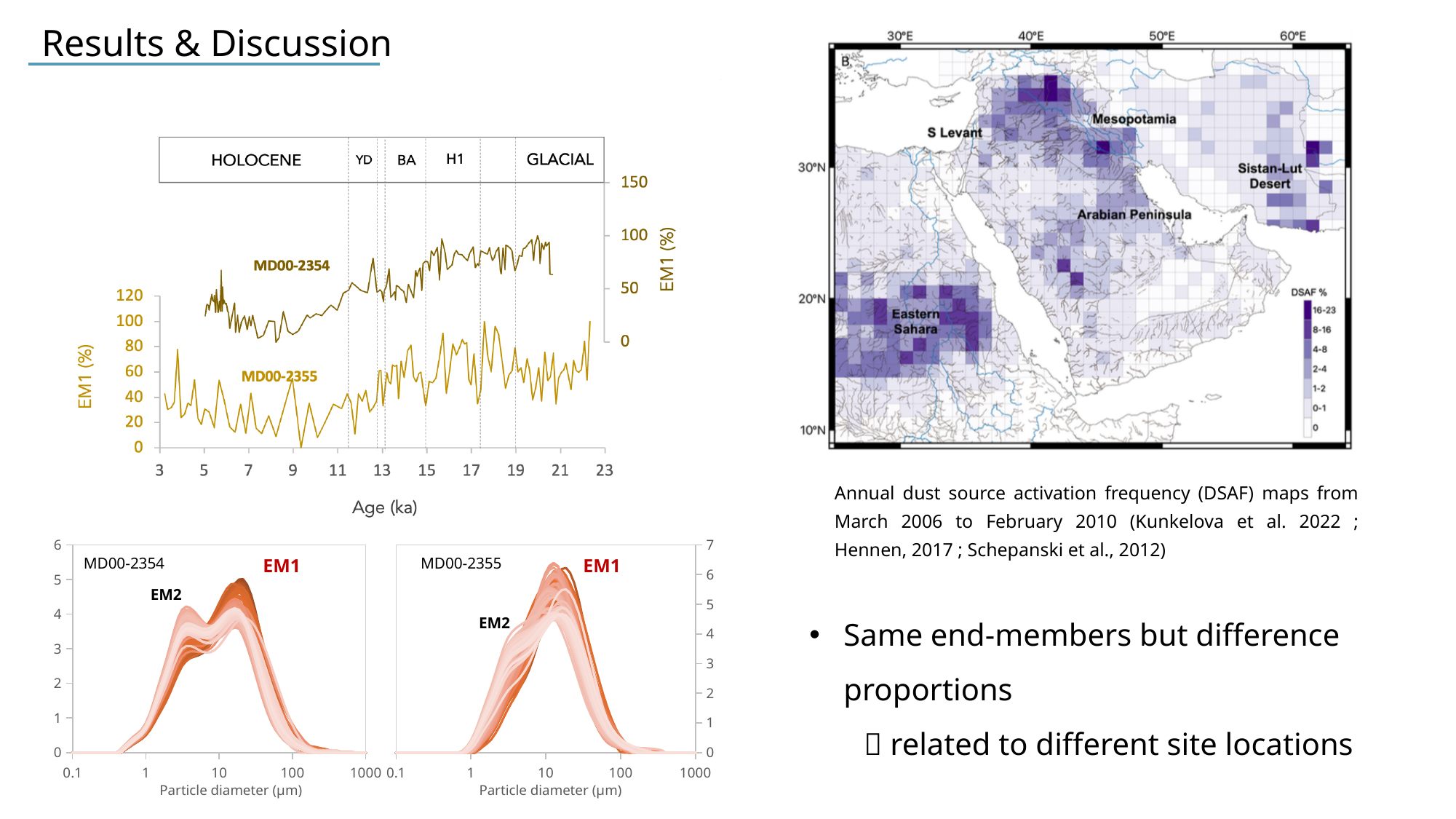
In the top-left EM1 (%) versus Age (ka) chart, is the MD00-2354 value at 5 ka greater or less than 50 on the right axis? less In the bottom-right MD00-2355 particle diameter chart, is the EM1 peak greater or less than 5 on the y axis? greater What is the x-axis label of the two bottom particle size distribution charts? Particle diameter (µm) In the bottom-left MD00-2354 particle diameter chart, which peak is higher, EM1 or EM2? EM1 In the top-left EM1 (%) versus Age (ka) chart, is the MD00-2355 value at 3 ka greater or less than 60 on the left axis? less In the top-left EM1 (%) versus Age (ka) chart, does the MD00-2354 series generally rise or fall as age increases from 5 ka to 20 ka? rise In the bottom-left MD00-2354 particle diameter chart, what is the maximum value shown on the y axis? 6 In the top-left EM1 (%) versus Age (ka) chart, what is the label of the x axis? Age (ka) What kind of chart is the top-left chart showing EM1 (%) against Age (ka)? line chart In the top-left EM1 (%) versus Age (ka) chart, how many series are plotted? 2 In the top-left EM1 (%) versus Age (ka) chart, what is the maximum value shown on the right-hand EM1 (%) axis? 150 In the top-left EM1 (%) versus Age (ka) chart, what are the names of the two plotted series? MD00-2354 and MD00-2355